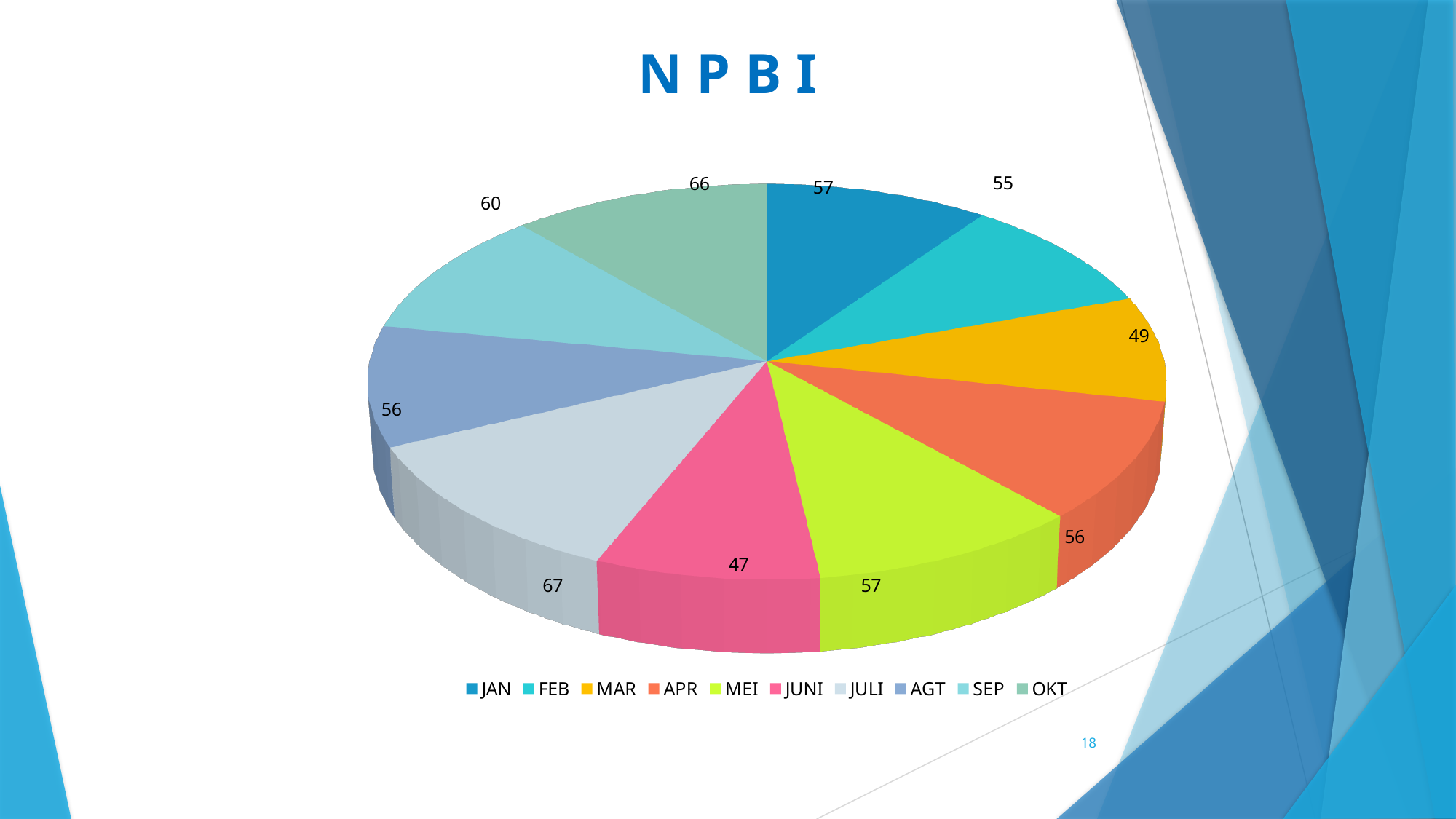
What is the value for SEP? 60 Which is larger, the value for OKT or the value for FEB? OKT What is the value for JUNI? 47 Which month has the largest value? JULI What is the title of the chart? NPBI Which month has the smallest value? JUNI What is the difference between the values for JULI and JUNI? 20 Which month is listed last in the legend? OKT What type of chart is shown on the slide? pie chart What is the value for MAR? 49 What is the value for JULI? 67 How many slices does the pie chart have? 10